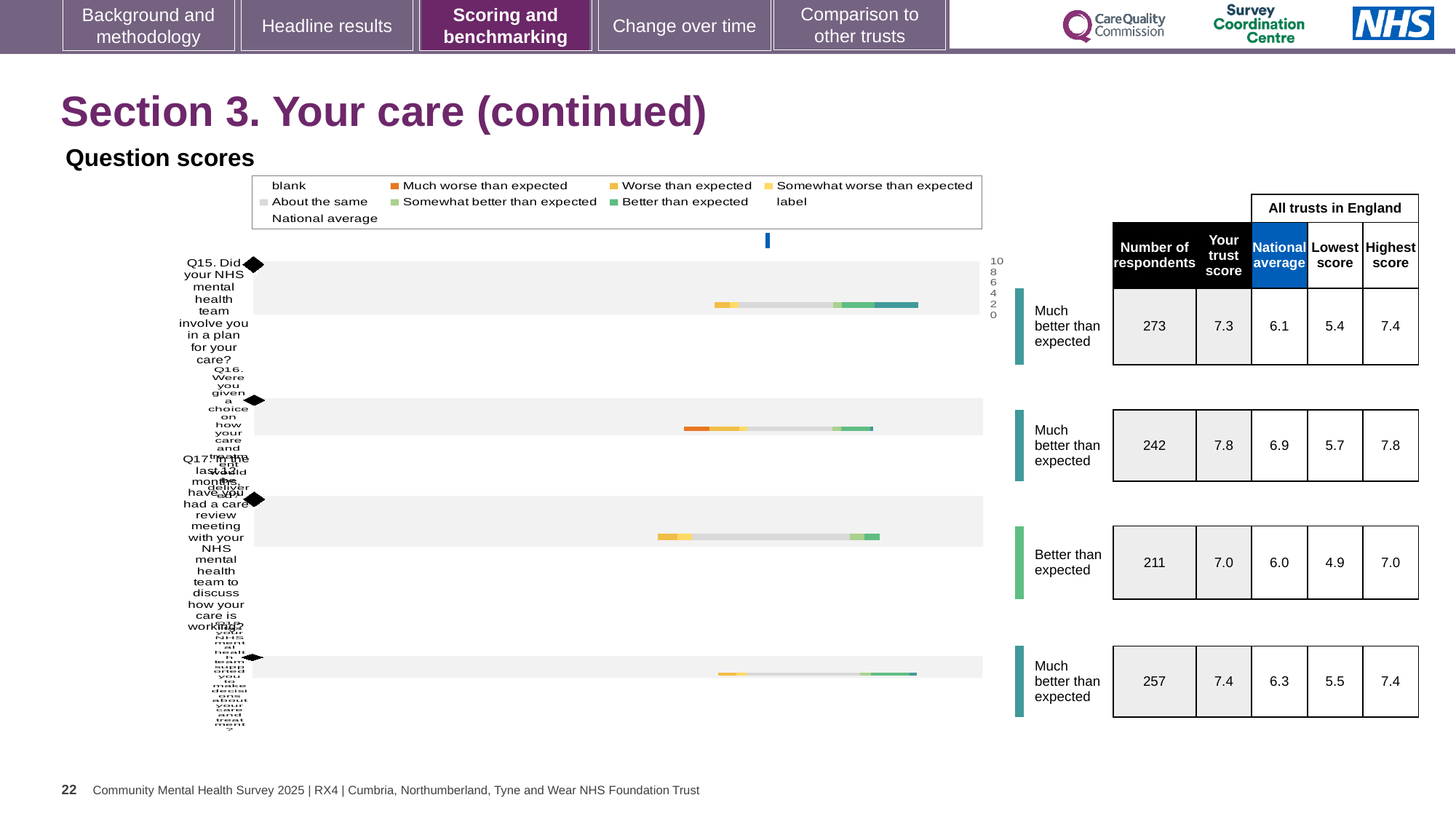
Which question has the lowest number of respondents in the table beside the chart? Q17 Which question has the highest trust score in the table beside the chart? Q16 How many question bars are plotted in the question scores chart? 4 In the table beside the chart, what is the number of respondents for Q15? 273 What colour is the legend marker for 'Much worse than expected'? orange In the table beside the chart, what is the national average for Q17? 6.0 What benchmark category is shown next to the Q17 bar? Better than expected By how much does the trust score for Q15 exceed the national average for Q15? 1.2 Which has the higher trust score, Q16 or Q17? Q16 In the table beside the chart, what is the trust score for Q16? 7.8 In the table beside the chart, what is the lowest score for Q16? 5.7 What kind of chart is used to show the question scores on this slide? bar chart